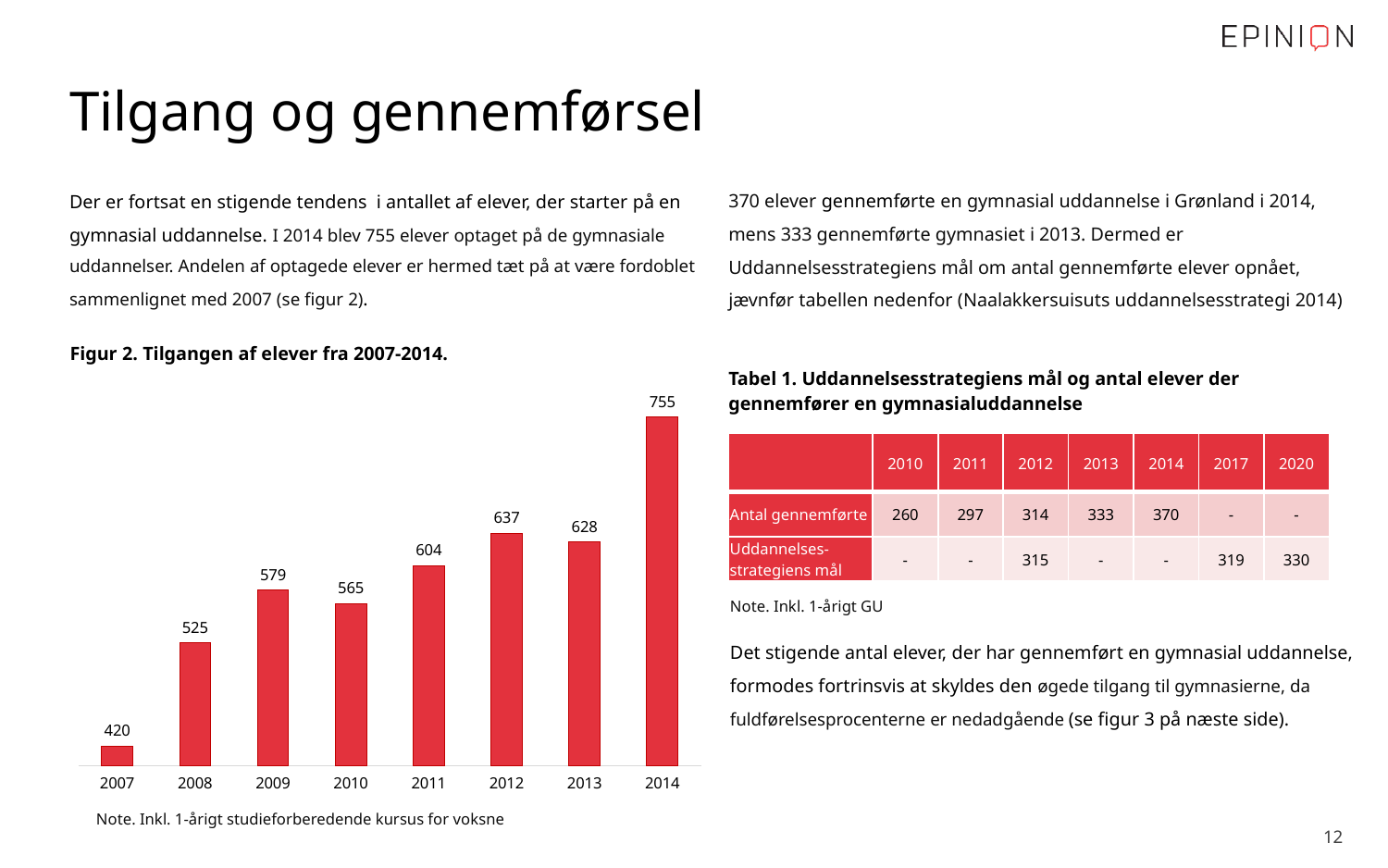
What is the difference between the values for 2012 and 2013 in Figur 2? 9 What is the value for 2011 in Figur 2? 604 What kind of chart is Figur 2? Bar chart What is the value for 2007 in Figur 2? 420 Which year has the highest value in Figur 2? 2014 What is the value for 2014 in Figur 2? 755 Which year has the lowest value in Figur 2? 2007 In Figur 2, which is larger, the value for 2009 or the value for 2010? 2009 In Figur 2, which is larger, the value for 2012 or the value for 2013? 2012 How many years are shown on the x axis of Figur 2? 8 What is the title of the chart on the slide? Figur 2. Tilgangen af elever fra 2007-2014. What is the difference between the values for 2014 and 2007 in Figur 2? 335